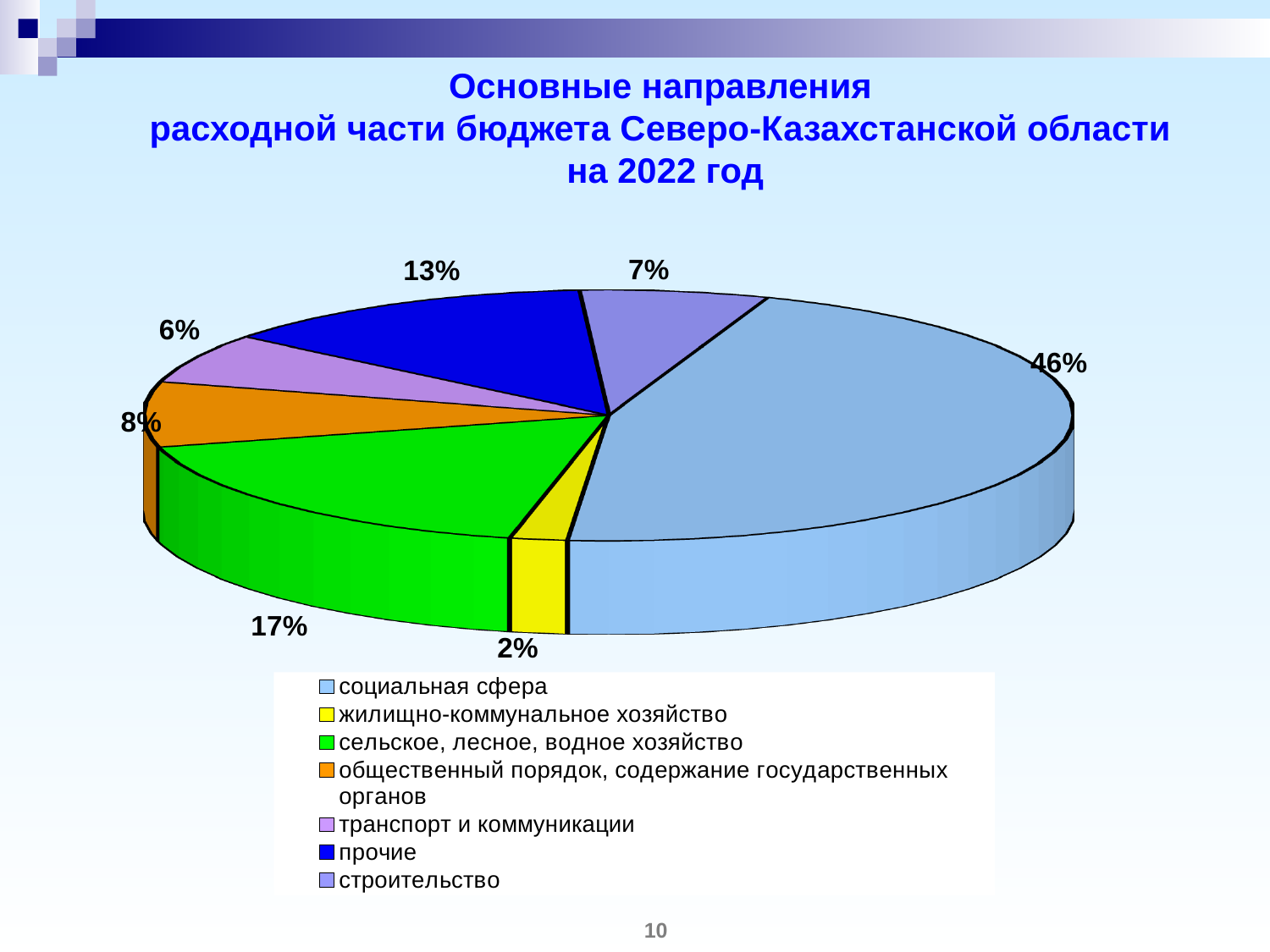
What percentage is shown for жилищно-коммунальное хозяйство? 2% What percentage is shown for сельское, лесное, водное хозяйство? 17% What type of chart is shown on the slide? pie chart What is the difference in percentage points between социальная сфера and сельское, лесное, водное хозяйство? 29 What year does the chart title refer to? 2022 Which category has the smallest share of the pie? жилищно-коммунальное хозяйство Which category has the largest share of the pie? социальная сфера How many categories does the legend list? 7 Which is larger: the share for общественный порядок, содержание государственных органов or the share for транспорт и коммуникации? общественный порядок, содержание государственных органов What share is labelled for прочие? 13% What share of the budget expenditure goes to социальная сфера? 46% What percentage is shown for строительство? 7%